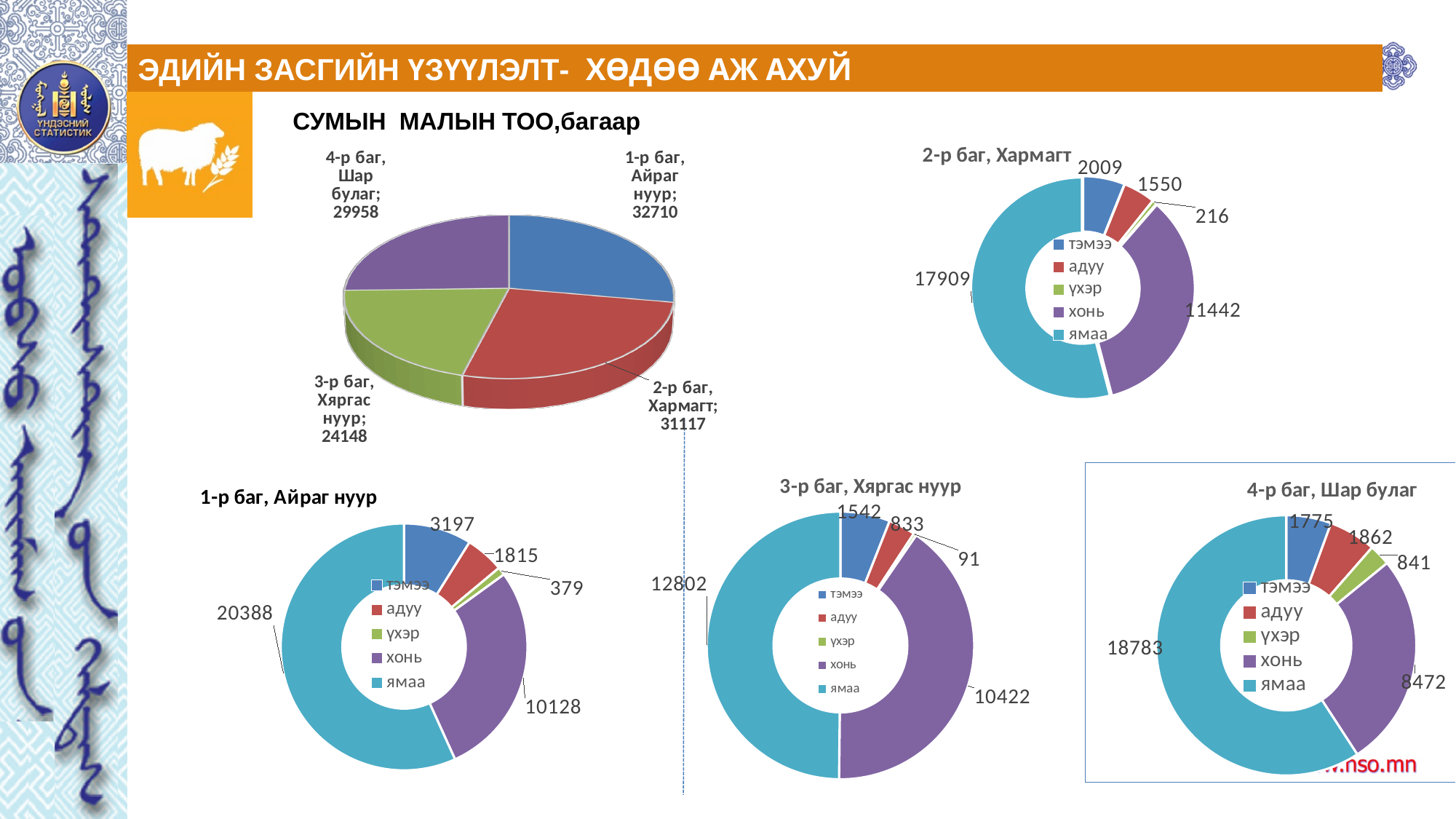
In the donut chart titled '1-р баг, Айраг нуур', which is larger, тэмээ or адуу? тэмээ How many categories does the pie chart titled 'СУМЫН МАЛЫН ТОО,багаар' show? 4 In the donut chart titled '2-р баг, Хармагт', which category has the lowest value? үхэр In the pie chart titled 'СУМЫН МАЛЫН ТОО,багаар', which баг has the lowest value? 3-р баг, Хяргас нуур In the donut chart titled '3-р баг, Хяргас нуур', what is the difference between ямаа and хонь? 2380 How many series does the legend of the donut chart titled '4-р баг, Шар булаг' list? 5 In the donut chart titled '2-р баг, Хармагт', what is the value for ямаа? 17909 In the pie chart titled 'СУМЫН МАЛЫН ТОО,багаар', what is the value for 1-р баг, Айраг нуур? 32710 In the donut chart titled '1-р баг, Айраг нуур', what is the value for хонь? 10128 In the donut chart titled '3-р баг, Хяргас нуур', what is the value for үхэр? 91 In the pie chart titled 'СУМЫН МАЛЫН ТОО,багаар', what is the difference between 1-р баг, Айраг нуур and 2-р баг, Хармагт? 1593 In the donut chart titled '4-р баг, Шар булаг', which category has the highest value? ямаа